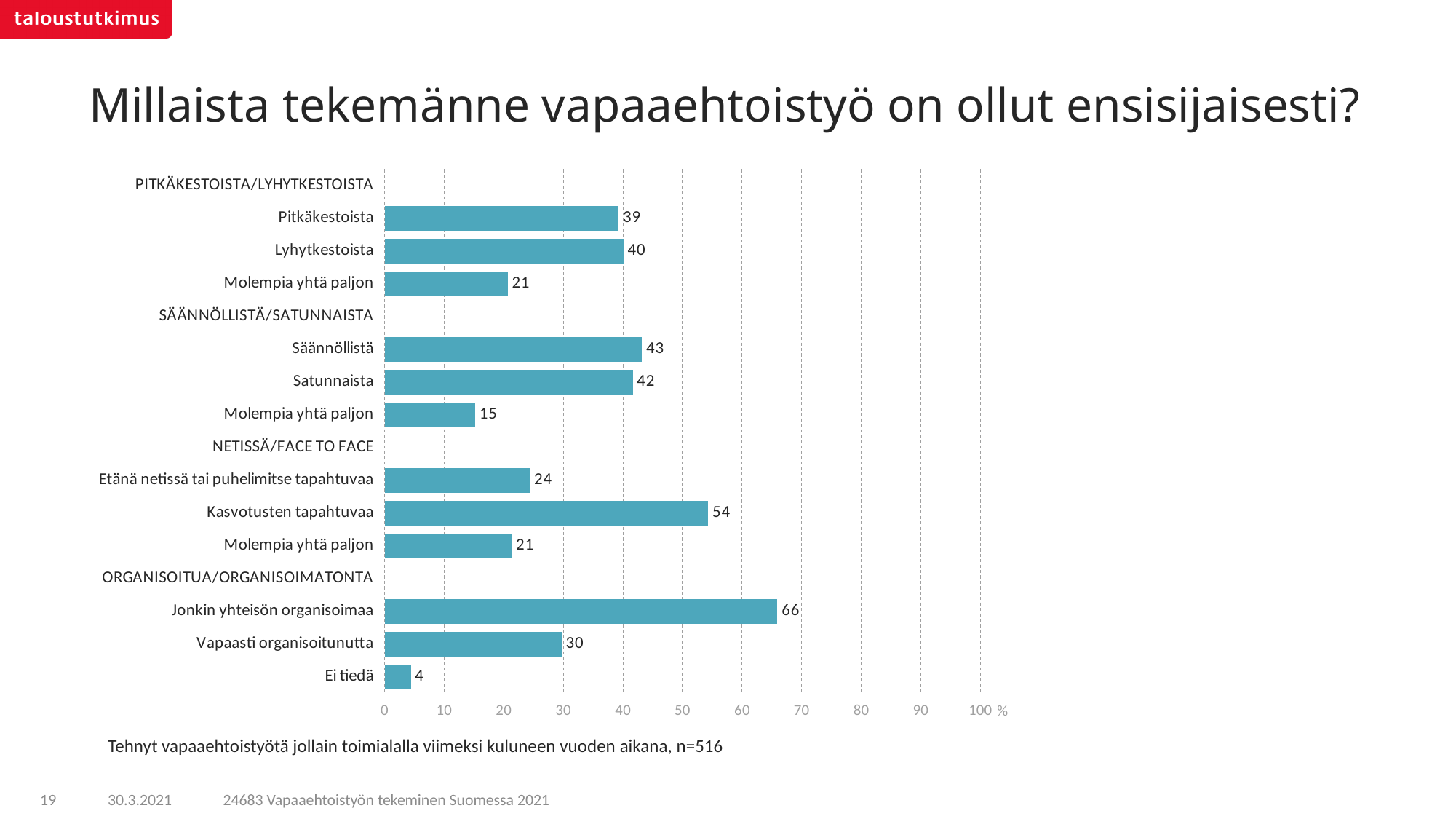
What is the value for Molempia yhtä paljon under SÄÄNNÖLLISTÄ/SATUNNAISTA? 15 How many bars are plotted in the chart? 12 What is the difference between Kasvotusten tapahtuvaa and Etänä netissä tai puhelimitse tapahtuvaa? 30 Which is larger, Pitkäkestoista or Lyhytkestoista? Lyhytkestoista What is the value for Etänä netissä tai puhelimitse tapahtuvaa? 24 What is the value for Kasvotusten tapahtuvaa? 54 Which category has the highest value? Jonkin yhteisön organisoimaa What is the value for Jonkin yhteisön organisoimaa? 66 What is the difference between Jonkin yhteisön organisoimaa and Vapaasti organisoitunutta? 36 Which category has the lowest value? Ei tiedä What kind of chart is shown on the slide? Bar chart What is the maximum value shown on the x axis? 100 %